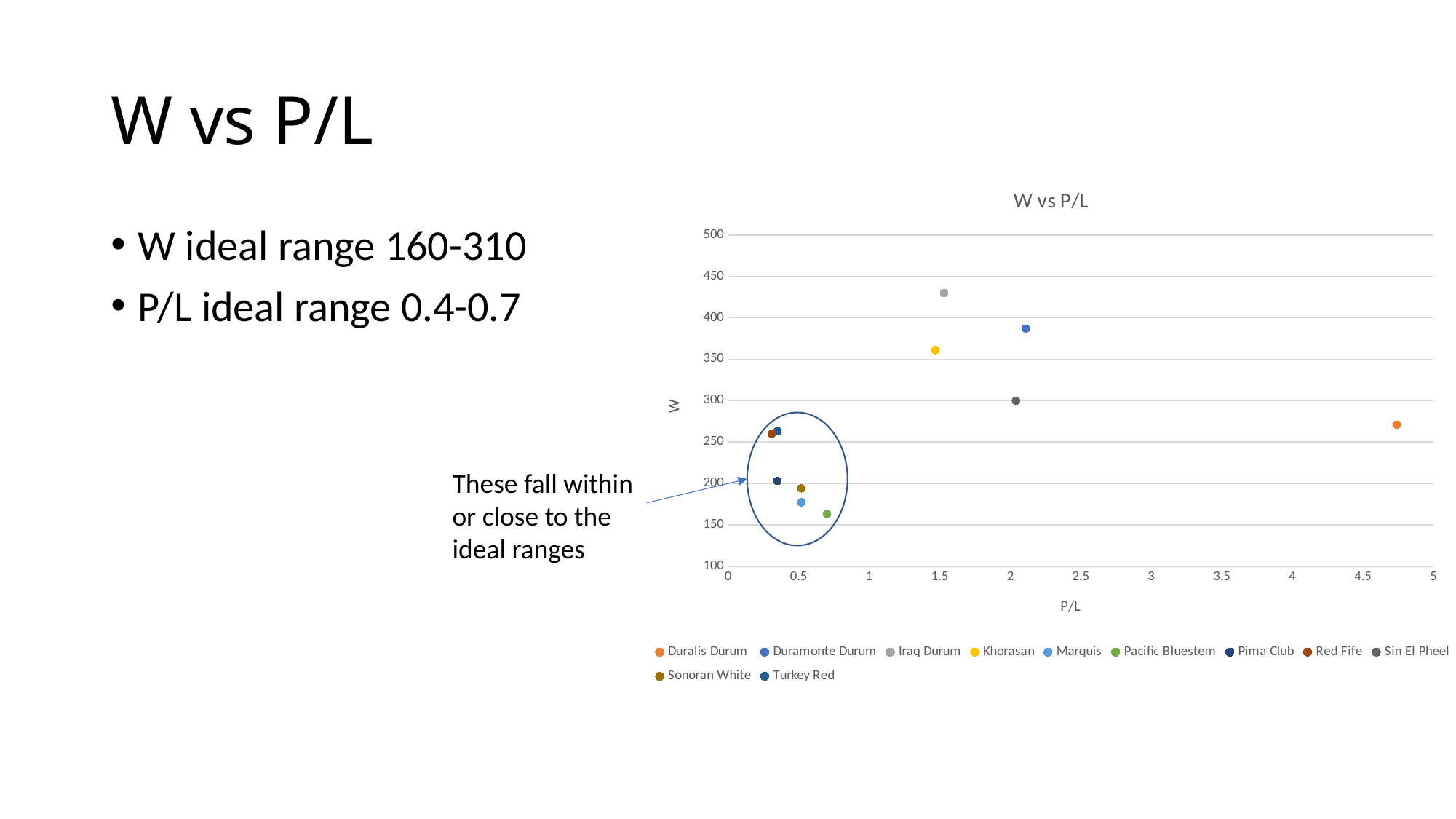
Which series has the highest P/L value in the chart? Duralis Durum Is the P/L value for Duralis Durum greater or less than 4.5? greater Which series has the highest W value in the chart? Iraq Durum What kind of chart is shown on the slide? scatter chart How many series does the legend of the W vs P/L chart list? 11 Is the W value for Iraq Durum greater or less than 400? greater What is the label of the horizontal axis of the chart? P/L Which has a higher P/L value, Sin El Pheel or Iraq Durum? Sin El Pheel Is the W value for Marquis greater or less than 200? less Which has a higher W value, Duramonte Durum or Khorasan? Duramonte Durum Which series has the lowest W value in the chart? Pacific Bluestem What is the title of the chart? W vs P/L